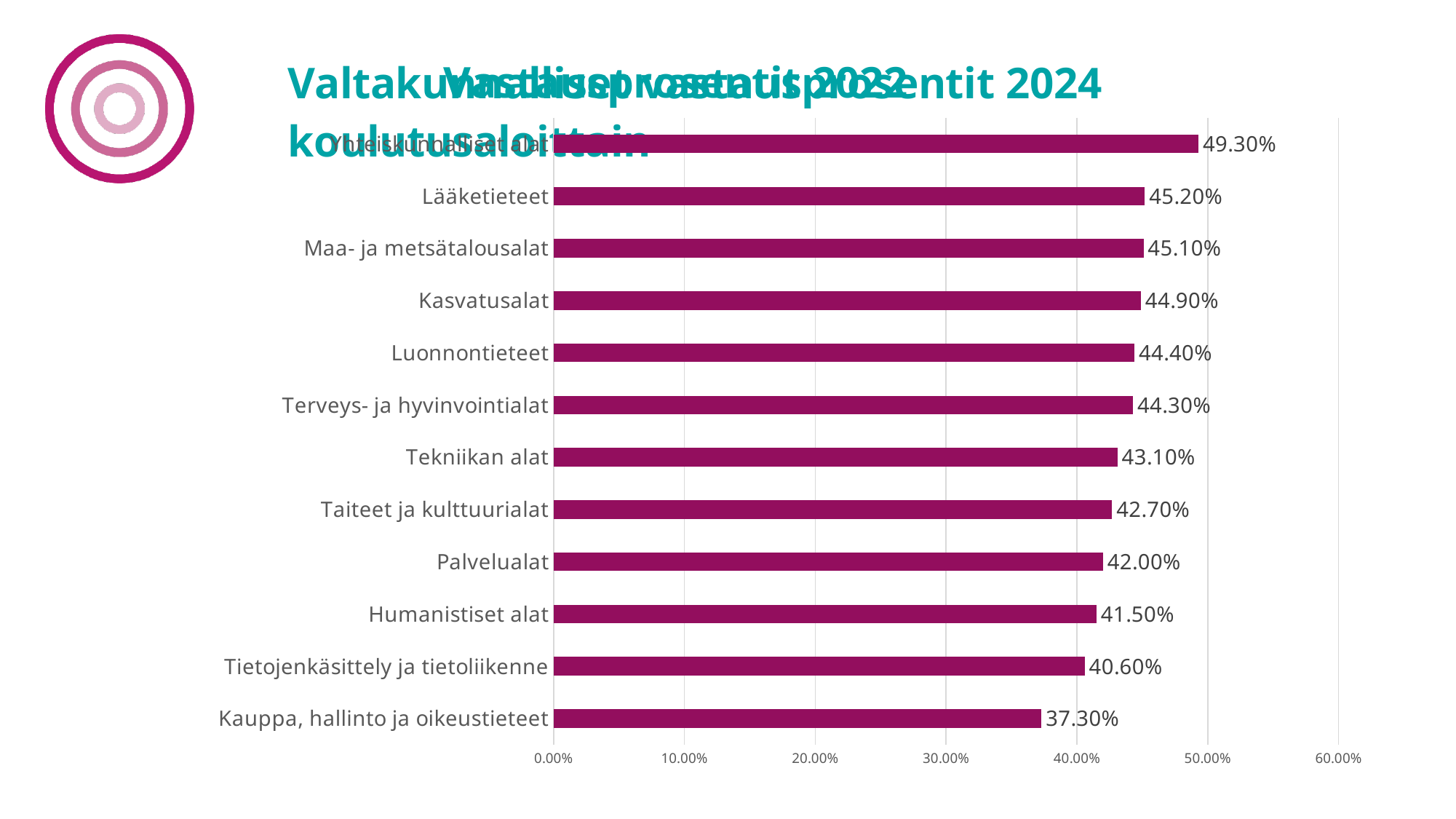
What is the value for Kauppa, hallinto ja oikeustieteet? 37.30% What is the highest value shown in the chart? 49.30% What is the difference between the values for Lääketieteet and Palvelualat? 3.20% What kind of chart is shown on the slide? bar chart What is the value for Tietojenkäsittely ja tietoliikenne? 40.60% Which category has the lowest value? Kauppa, hallinto ja oikeustieteet What is the value for Lääketieteet? 45.20% Is the value for Kauppa, hallinto ja oikeustieteet greater or less than 40.00%? less How many categories are shown in the chart? 12 What is the maximum value shown on the horizontal axis? 60.00% Which is larger, the value for Luonnontieteet or the value for Humanistiset alat? Luonnontieteet What is the value for Tekniikan alat? 43.10%